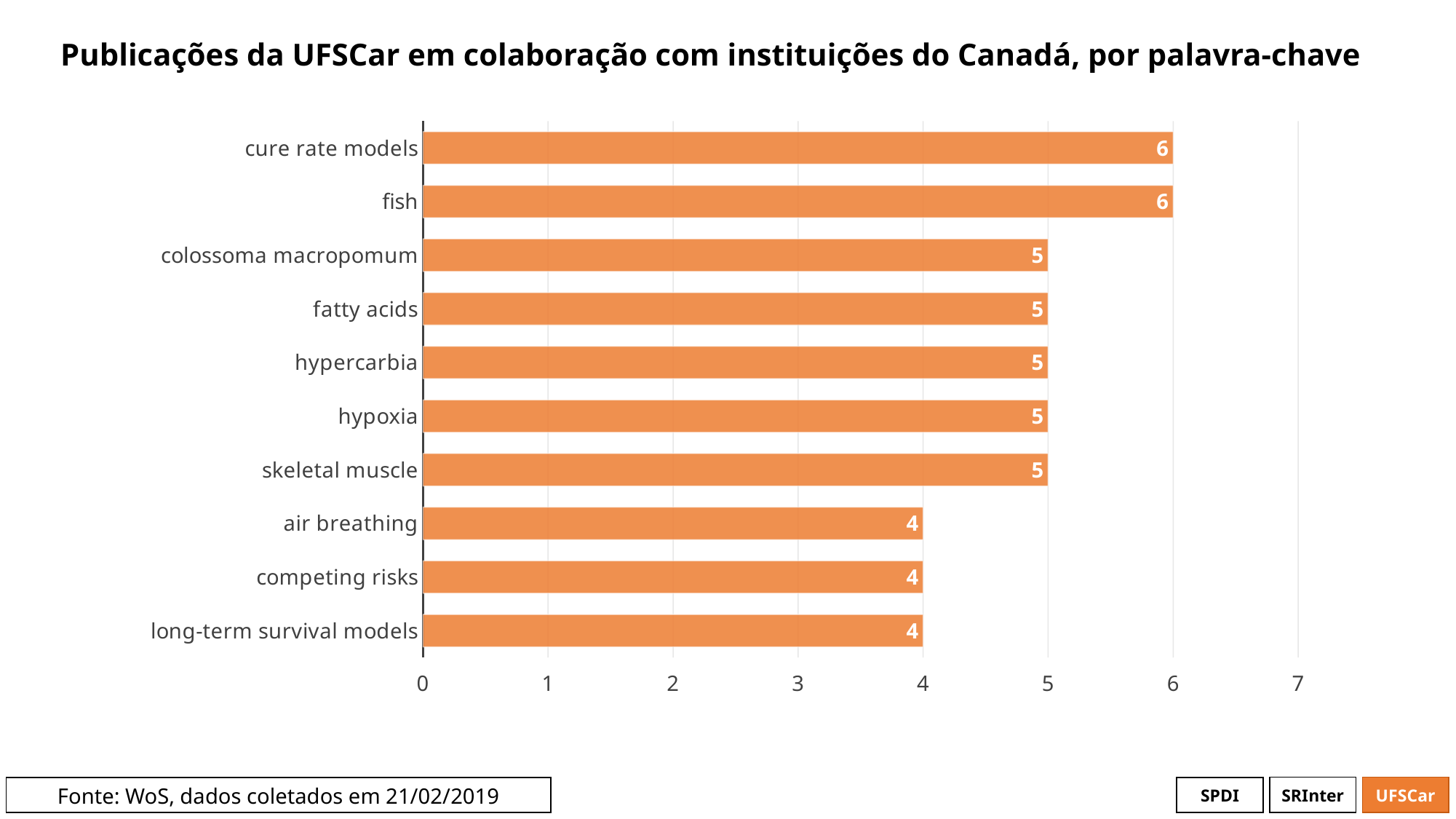
What is the value for 'cure rate models'? 6 What colour are the bars in the chart? orange What is the difference between the values for 'fish' and 'air breathing'? 2 What is the difference between the values for 'hypercarbia' and 'competing risks'? 1 What is the value for 'colossoma macropomum'? 5 What kind of chart is shown on the slide? bar chart What is the value for 'hypoxia'? 5 What is the value for 'competing risks'? 4 How many categories are shown in the chart? 10 Is the value for 'skeletal muscle' greater or less than 4? greater Which is larger, the value for 'fatty acids' or the value for 'long-term survival models'? fatty acids What is the title of the chart? Publicações da UFSCar em colaboração com instituições do Canadá, por palavra-chave